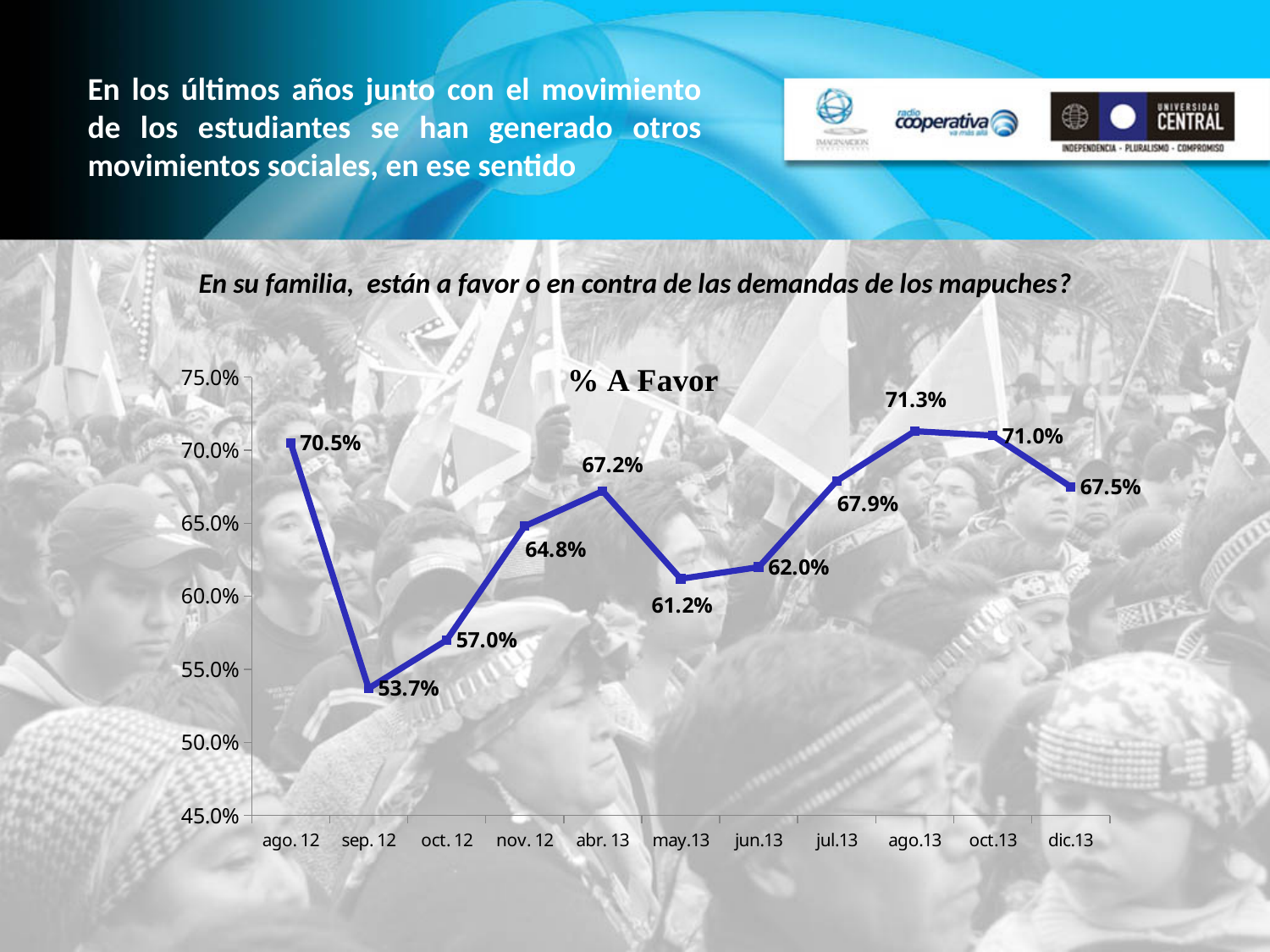
What is the value for sep. 12? 53.7% How many months are plotted on the chart? 11 What kind of chart is shown? line chart Which is larger, the value for may.13 or the value for jun.13? jun.13 What is the value for abr. 13? 67.2% What is the value for ago. 12? 70.5% Is the value for nov. 12 greater or less than 60.0%? greater What is the title of the chart? % A Favor What is the value for dic.13? 67.5% Which month has the highest value? ago.13 Which month has the lowest value? sep. 12 What is the difference between the values for ago.13 and sep. 12? 17.6%